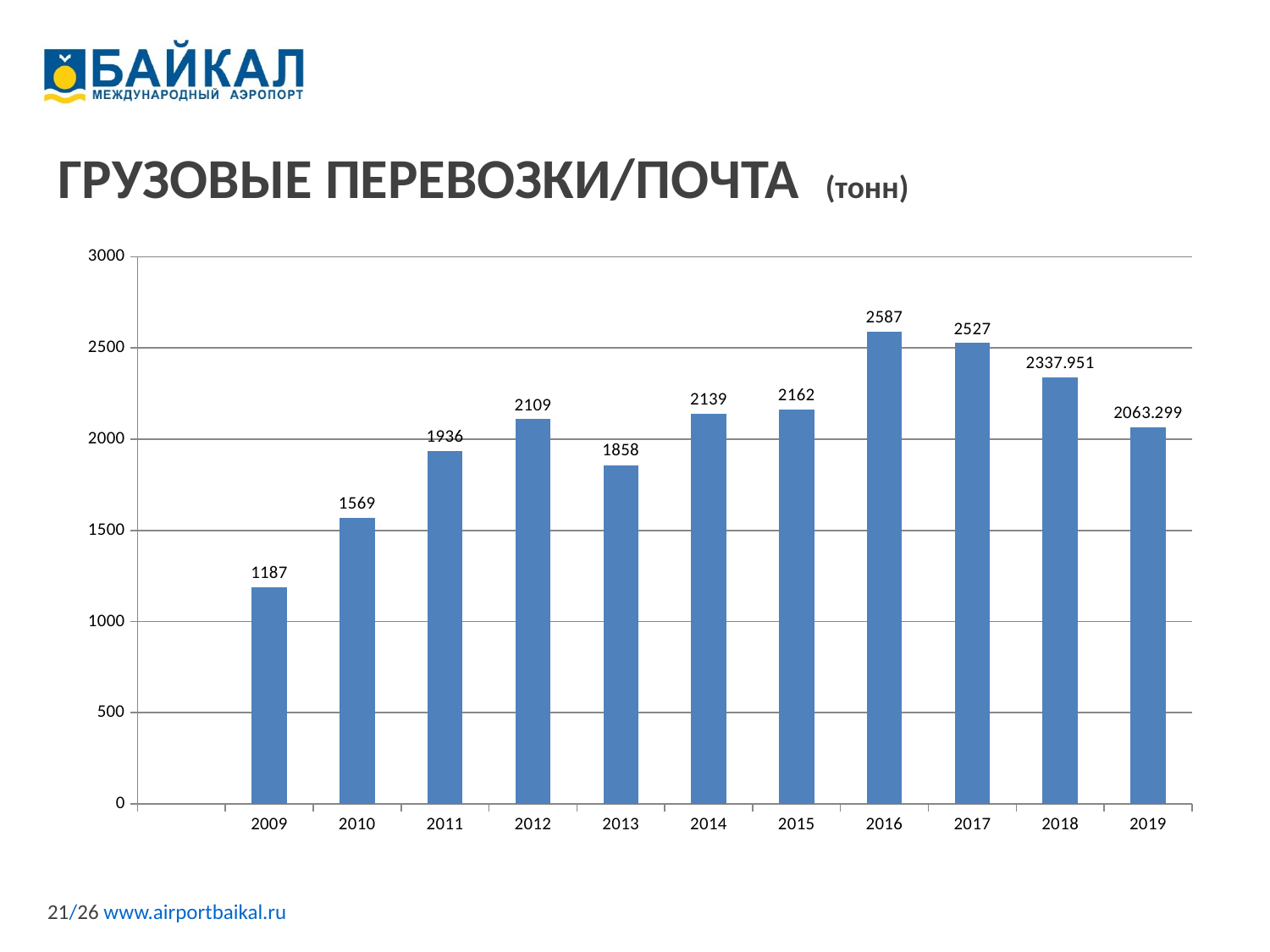
What is the value for 2016? 2587 What is the difference between the values for 2016 and 2017? 60 What is the value for 2009? 1187 Which year has the highest value? 2016 How many years are shown on the x axis? 11 Which year has the lowest value? 2009 Which is larger, the value for 2012 or the value for 2013? 2012 What is the value for 2019? 2063.299 What is the title of the chart? ГРУЗОВЫЕ ПЕРЕВОЗКИ/ПОЧТА (тонн) What is the value for 2018? 2337.951 What is the difference between the values for 2010 and 2009? 382 What kind of chart is shown on the slide? Bar chart